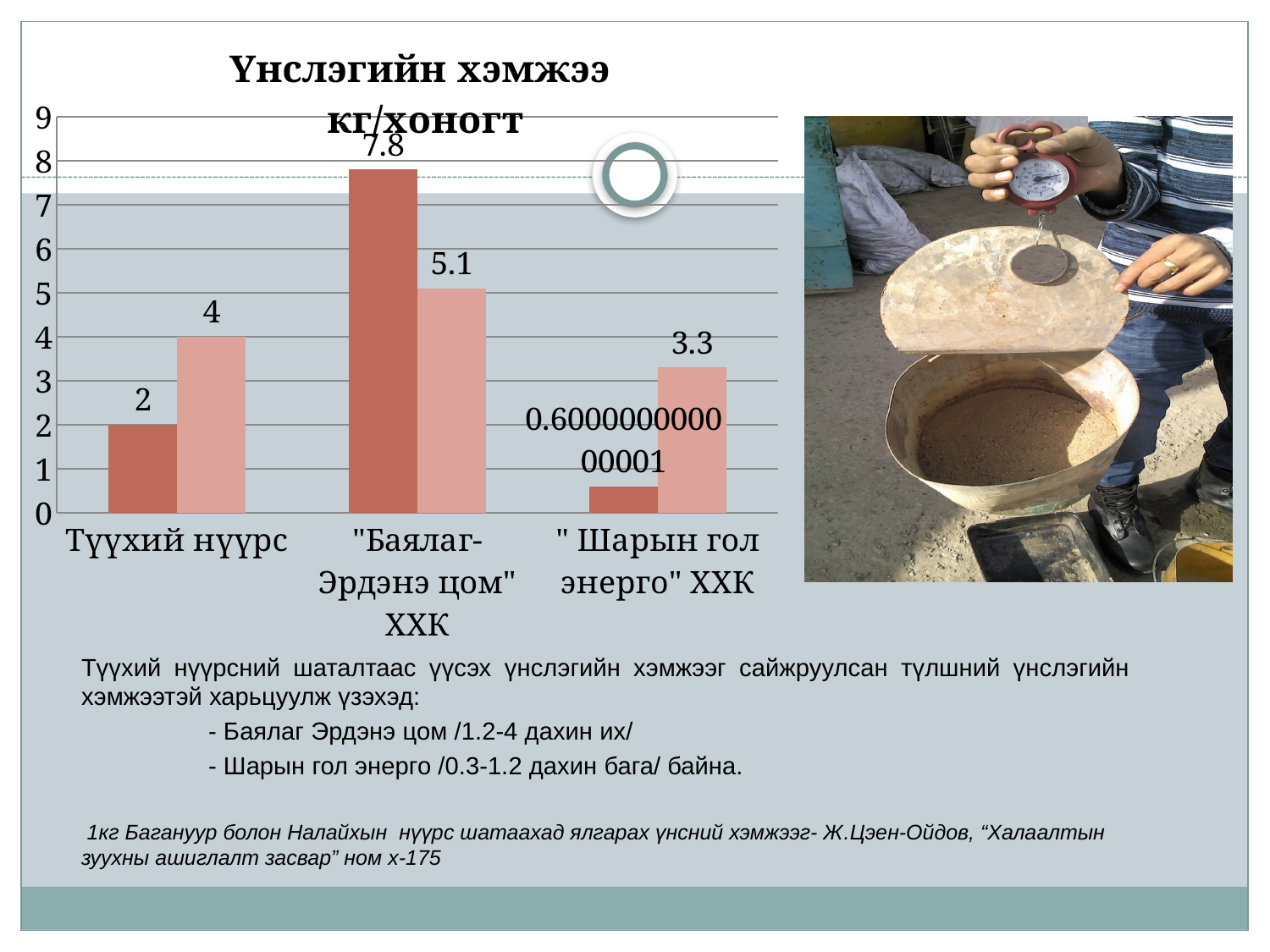
Is the dark red bar for "Шарын гол энерго" ХХК greater or less than 1? less What is the difference between the dark red and light pink bars for "Баялаг-Эрдэнэ цом" ХХК? 2.7 How many categories are shown on the x axis of the chart? 3 What is the value of the dark red bar for "Баялаг-Эрдэнэ цом" ХХК? 7.8 Which category has the highest bar in the chart? "Баялаг-Эрдэнэ цом" ХХК What is the value of the light pink bar for "Баялаг-Эрдэнэ цом" ХХК? 5.1 Which is larger: the light pink bar for Түүхий нүүрс or the light pink bar for "Шарын гол энерго" ХХК? Түүхий нүүрс What is the value of the light pink bar for Түүхий нүүрс? 4 What is the difference between the light pink and dark red bars for Түүхий нүүрс? 2 What is the value of the dark red bar for Түүхий нүүрс? 2 What is the title of the chart? Үнслэгийн хэмжээ кг/хоногт What is the value of the light pink bar for "Шарын гол энерго" ХХК? 3.3